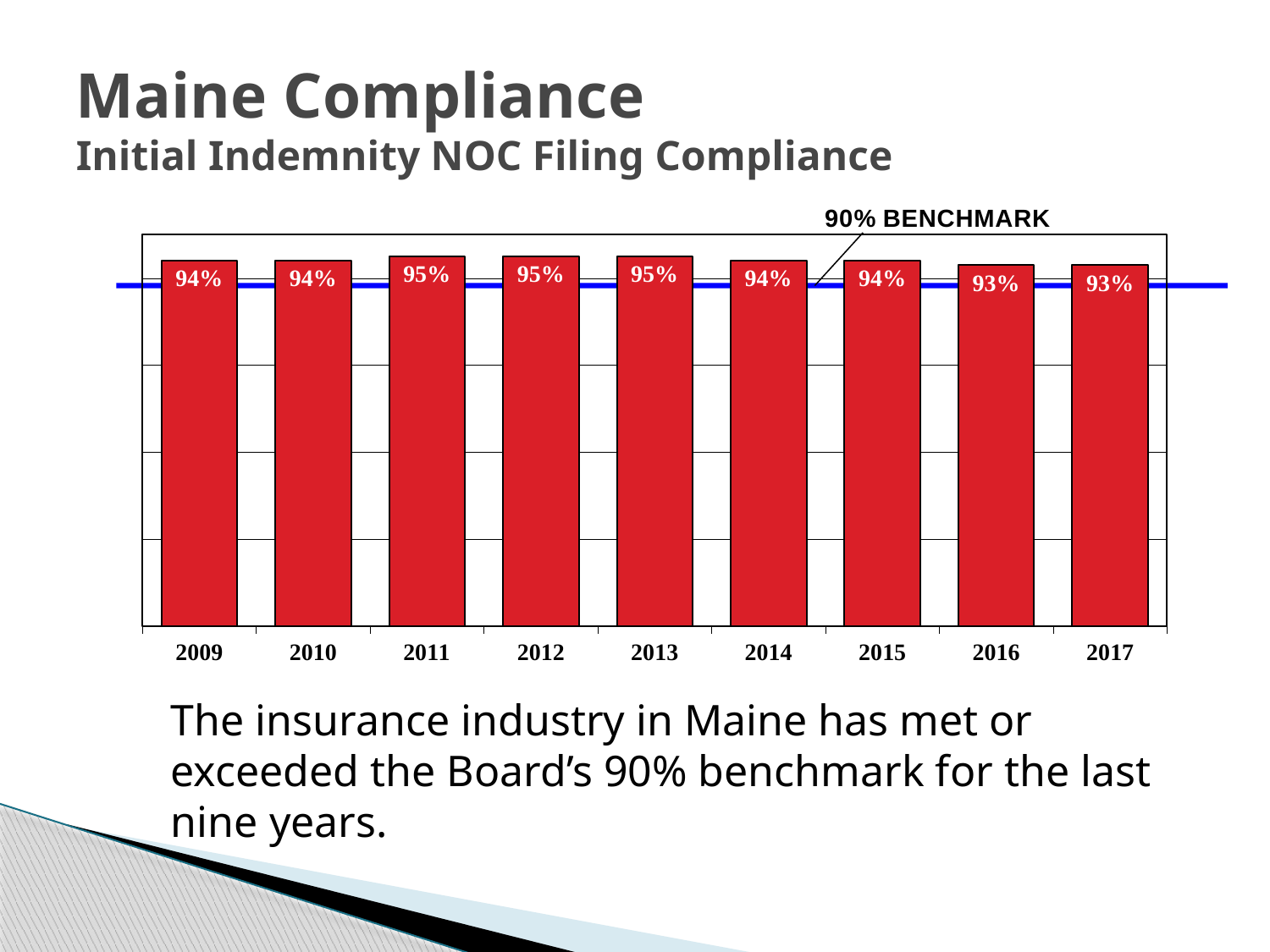
Which year has the larger value, 2012 or 2016? 2012 What is the lowest compliance value shown on the chart? 93% What is the highest compliance value shown on the chart? 95% What is the difference between the 2013 value and the 2017 value? 2 percentage points Is the value for 2015 greater or less than the 90% benchmark line? greater What kind of chart is shown on the slide? bar chart What value does the horizontal blue line on the chart represent? 90% benchmark How many years are shown on the x axis? 9 What is the compliance value for 2017? 93% What is the compliance value for 2011? 95% What is the compliance value for 2009? 94% Do the values rise or fall from 2013 to 2017? fall